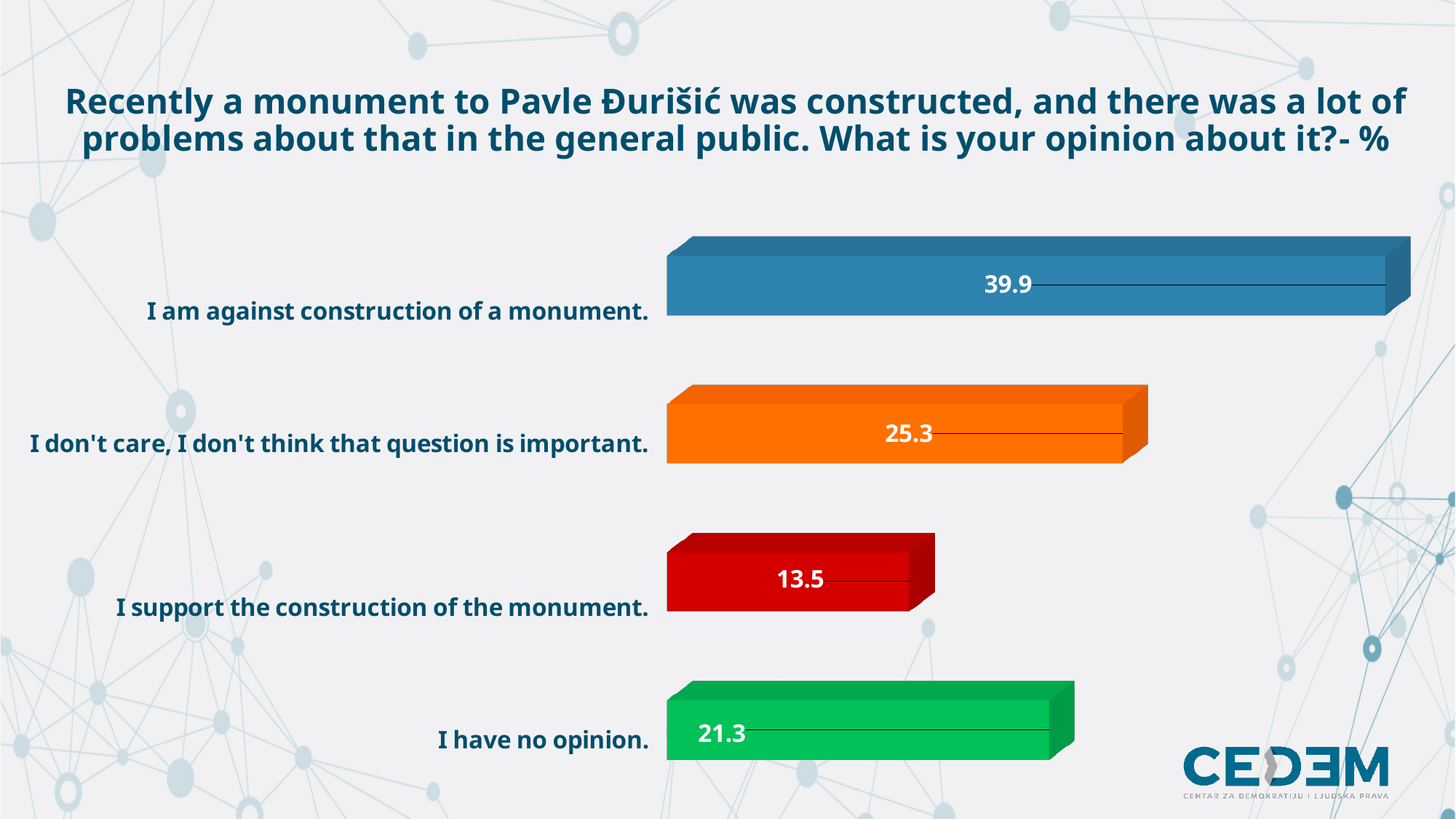
What is the value for "I support the construction of the monument."? 13.5 What kind of chart is shown on the slide? Bar chart Which category has the highest value? I am against construction of a monument. How many categories are shown in the chart? 4 What is the value for "I am against construction of a monument."? 39.9 Which is larger: the value for "I have no opinion." or the value for "I support the construction of the monument."? I have no opinion. What is the difference between the values for "I am against construction of a monument." and "I support the construction of the monument."? 26.4 What colour is the bar for "I support the construction of the monument."? Red What is the value for "I have no opinion."? 21.3 What is the value for "I don't care, I don't think that question is important."? 25.3 Which category has the lowest value? I support the construction of the monument. What is the difference between the values for "I don't care, I don't think that question is important." and "I have no opinion."? 4